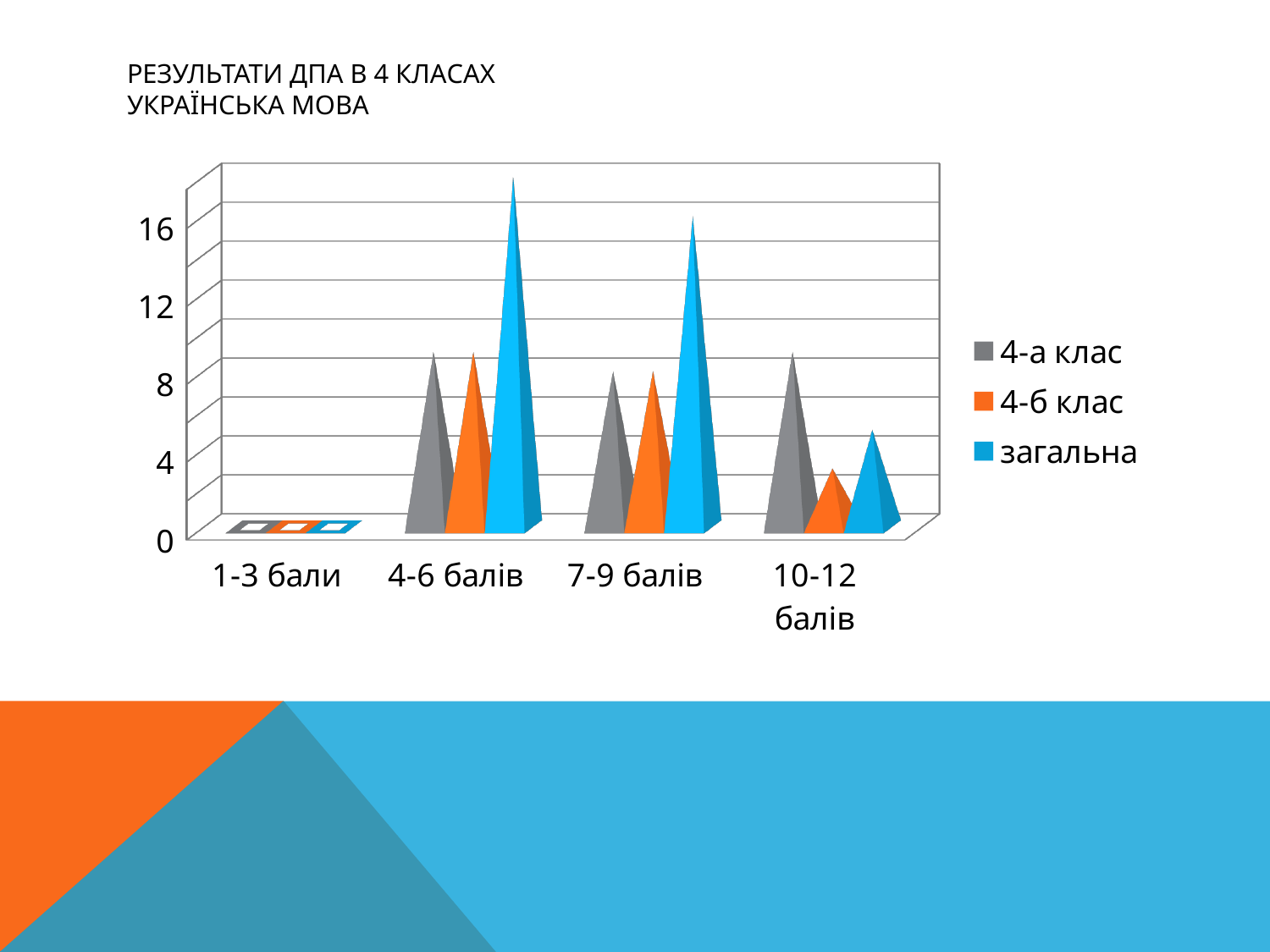
How many score categories are shown on the x axis? 4 Is the value for 4-б клас in the 10-12 балів category greater or less than 4? less Which category has the lowest value for 4-б клас? 1-3 бали What kind of chart is shown on the slide? bar chart Which category has the highest value for загальна? 4-6 балів What is the value for загальна in the 1-3 бали category? 0 Which is larger: the value for 4-б клас in 4-6 балів or in 10-12 балів? 4-6 балів What is the value for 4-а клас in the 1-3 бали category? 0 Which series is shown in orange in the legend? 4-б клас How many series does the legend list? 3 Is the value for загальна in the 4-6 балів category greater or less than 16? greater What is the title of the slide above the chart? РЕЗУЛЬТАТИ ДПА В 4 КЛАСАХ УКРАЇНСЬКА МОВА